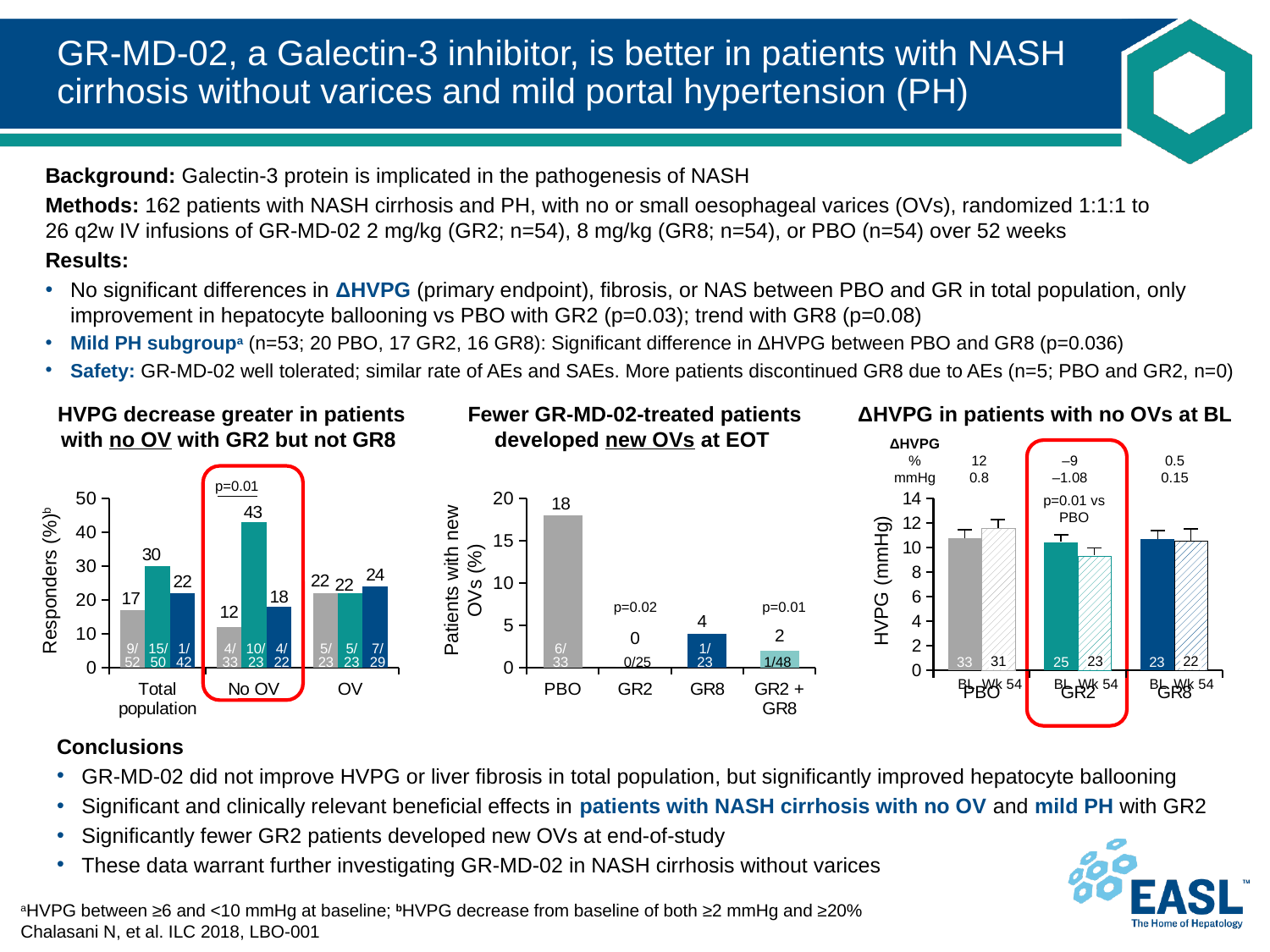
In the right chart titled 'ΔHVPG in patients with no OVs at BL', is the baseline (BL) HVPG for PBO greater or less than 8 mmHg? greater In the left chart titled 'HVPG decrease greater in patients with no OV with GR2 but not GR8', how many patient groups are shown on the x axis? 3 In the left chart titled 'HVPG decrease greater in patients with no OV with GR2 but not GR8', what is the highest responder percentage in the No OV group? 43 In the chart titled 'Fewer GR-MD-02-treated patients developed new OVs at EOT', what percentage of PBO patients developed new OVs? 18 In the chart titled 'Fewer GR-MD-02-treated patients developed new OVs at EOT', how many groups are shown on the x axis? 4 In the right chart titled 'ΔHVPG in patients with no OVs at BL', what is the ΔHVPG in mmHg for GR2? −1.08 In the chart titled 'Fewer GR-MD-02-treated patients developed new OVs at EOT', which group has the lowest percentage of patients with new OVs? GR2 What is the y-axis label of the left chart titled 'HVPG decrease greater in patients with no OV with GR2 but not GR8'? Responders (%) What type of chart is the middle chart titled 'Fewer GR-MD-02-treated patients developed new OVs at EOT'? Bar chart In the chart titled 'Fewer GR-MD-02-treated patients developed new OVs at EOT', what is the difference between the PBO and GR8 values? 14 In the chart titled 'Fewer GR-MD-02-treated patients developed new OVs at EOT', what is the value for GR8? 4 In the left chart titled 'HVPG decrease greater in patients with no OV with GR2 but not GR8', what is the highest responder percentage in the Total population group? 30